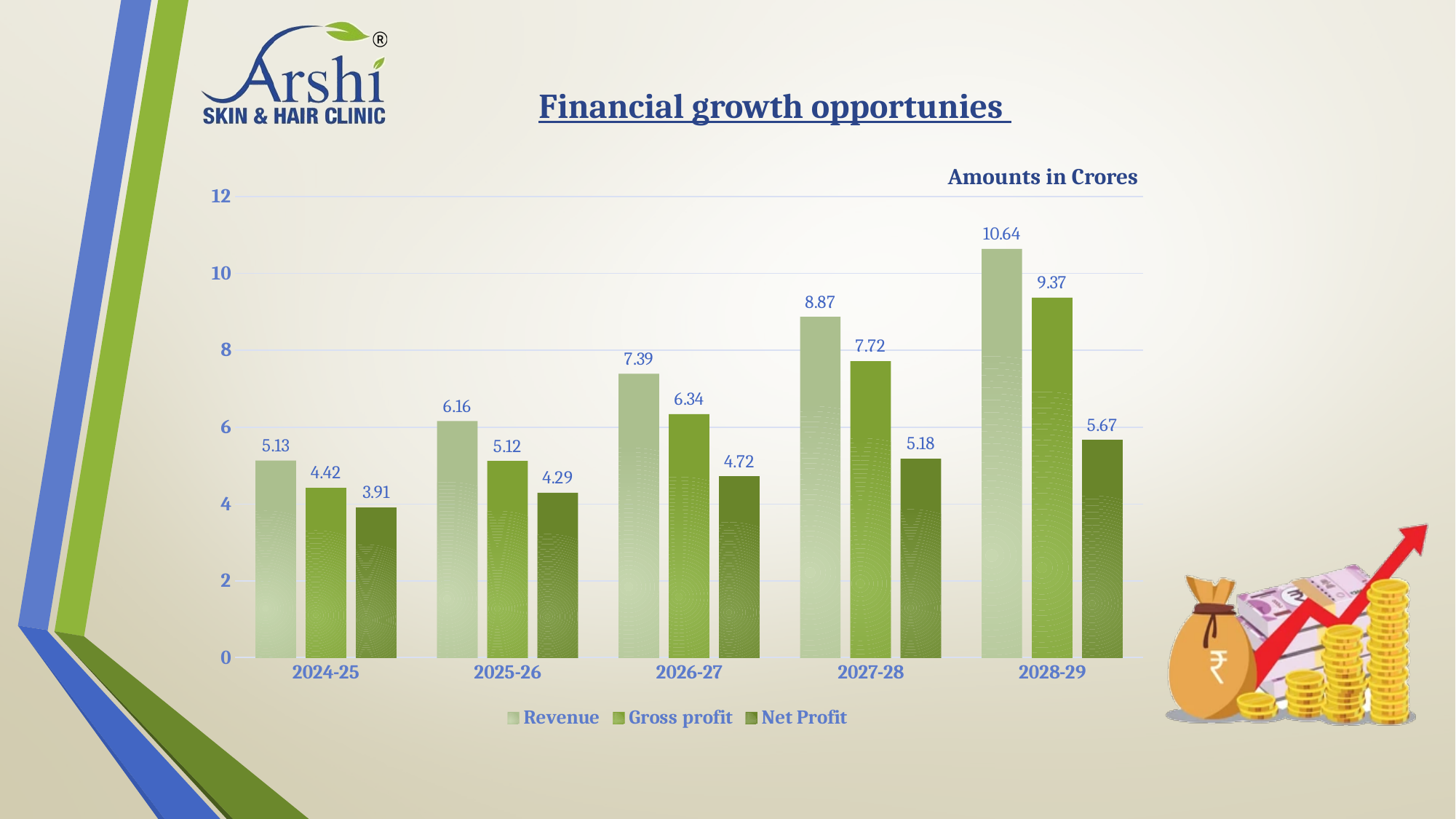
What is the Revenue value for 2026-27? 7.39 How many series does the legend list? 3 What is the difference between Revenue and Gross profit in 2027-28? 1.15 What kind of chart is shown on the slide? bar chart Which is larger: Gross profit in 2025-26 or Net Profit in 2028-29? Net Profit in 2028-29 How many years are shown on the x axis? 5 What is the Net Profit value for 2024-25? 3.91 Which year has the highest Revenue? 2028-29 What is the Gross profit value for 2028-29? 9.37 Which year has the lowest Net Profit? 2024-25 Does Net Profit rise or fall from 2024-25 to 2028-29? rise Is the Revenue value for 2028-29 greater or less than 10? greater